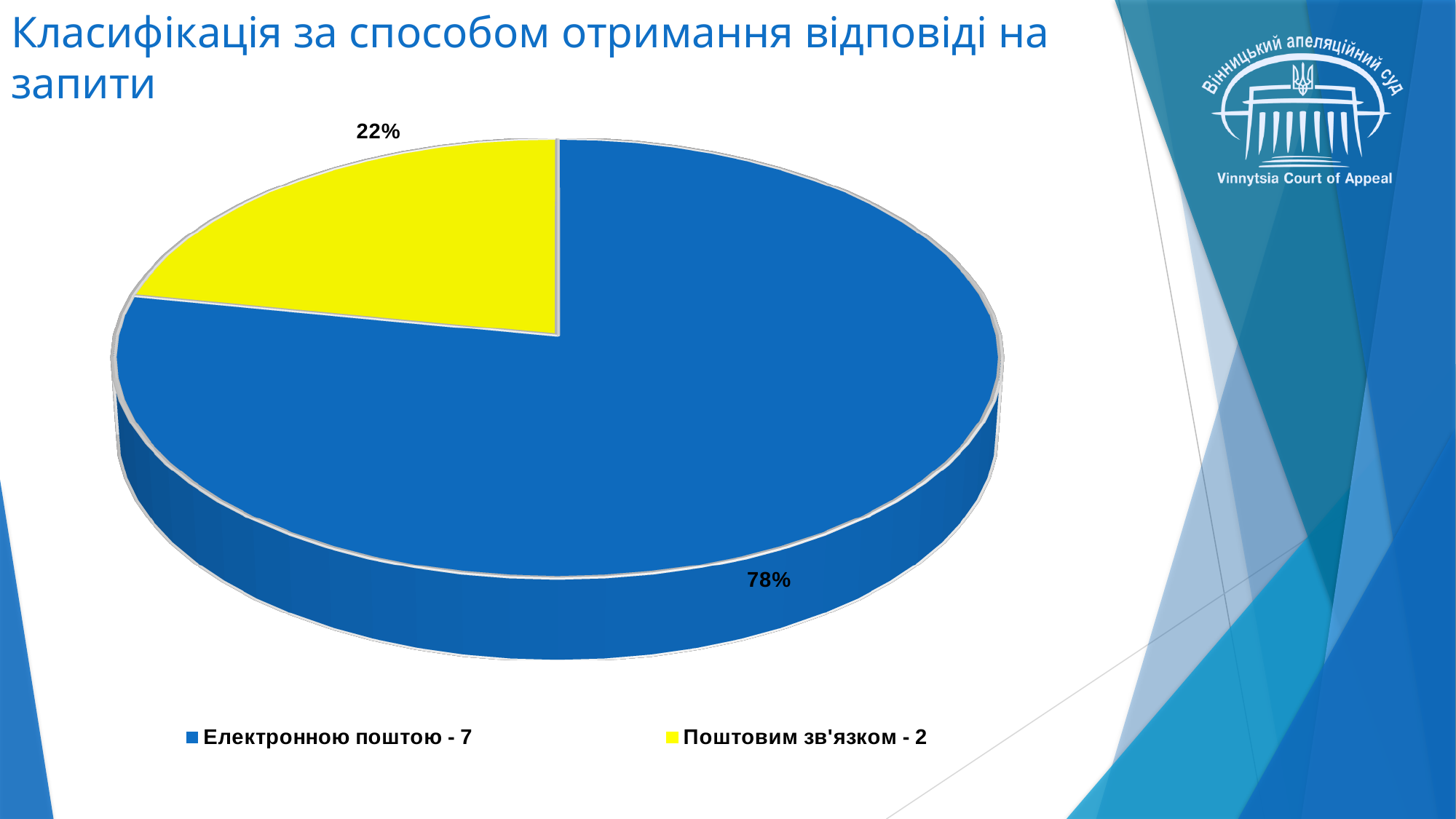
What kind of chart is shown on the slide? pie chart Is the share for "Електронною поштою" greater or less than 50%? greater How many entries does the legend list? 2 Which category has the largest slice of the pie? Електронною поштою - 7 What is the title of the slide containing the pie chart? Класифікація за способом отримання відповіді на запити Which category has the smallest slice of the pie? Поштовим зв'язком - 2 How many slices does the pie chart have? 2 What percentage share does the slice "Поштовим зв'язком - 2" have? 22% Which slice is larger: "Електронною поштою" or "Поштовим зв'язком"? Електронною поштою What colour is the slice for "Поштовим зв'язком - 2"? yellow What is the difference in percentage points between the "Електронною поштою" slice and the "Поштовим зв'язком" slice? 56% What percentage share does the slice "Електронною поштою - 7" have? 78%